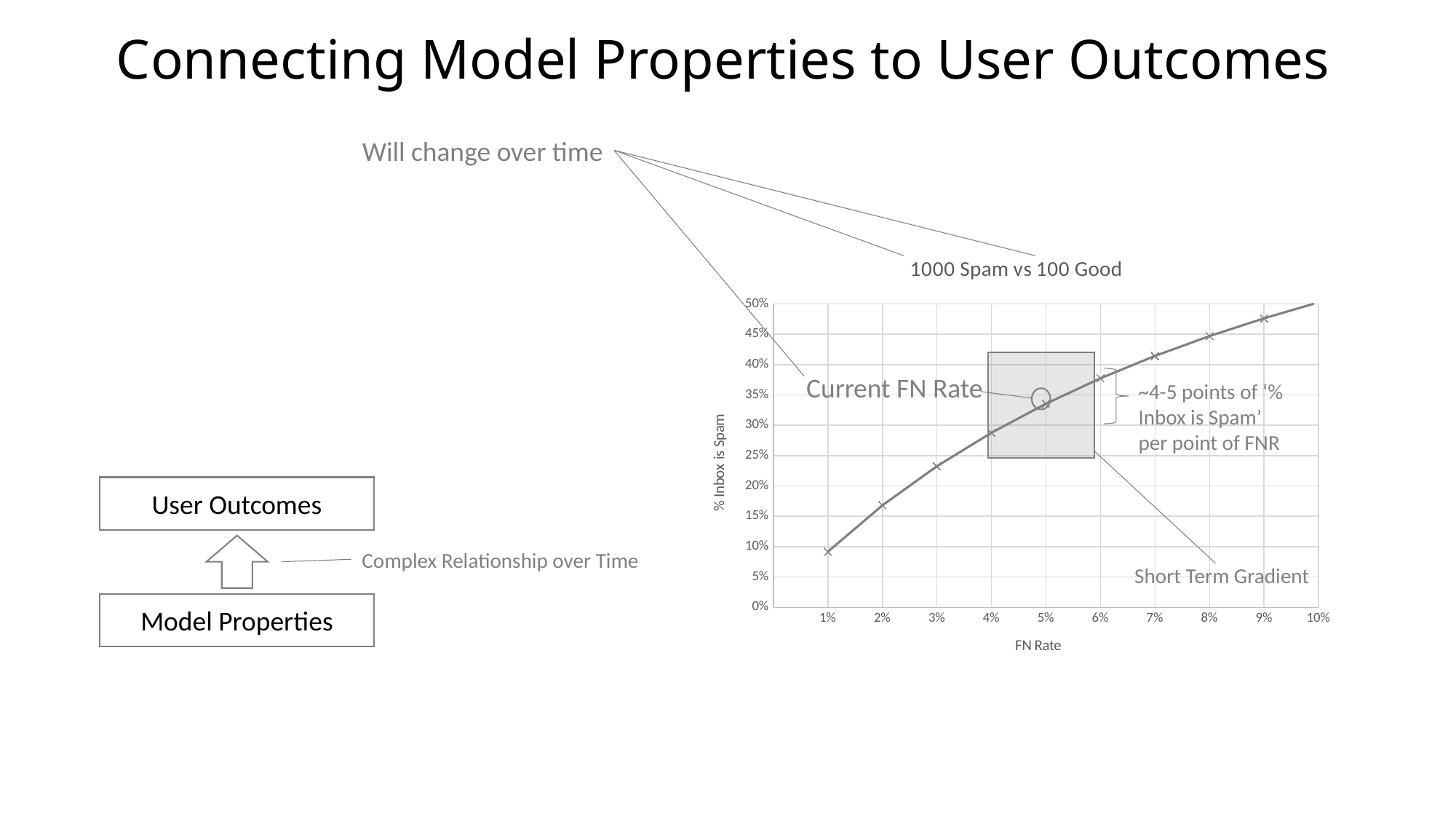
Is the % Inbox is Spam value at an FN Rate of 2% greater or less than 15%? greater At which FN Rate is the % Inbox is Spam value highest? 10% What kind of chart is shown on the slide? line chart Is the % Inbox is Spam value at an FN Rate of 1% greater or less than 10%? less What is the label of the x axis of the chart? FN Rate What is the title of the chart? 1000 Spam vs 100 Good How many data points are plotted on the chart? 10 Which has a higher % Inbox is Spam value: an FN Rate of 3% or an FN Rate of 7%? 7% At which FN Rate is the % Inbox is Spam value lowest? 1% Is the % Inbox is Spam value at an FN Rate of 4% greater or less than 25%? greater Does the % Inbox is Spam value rise or fall as the FN Rate increases along the x axis? rise